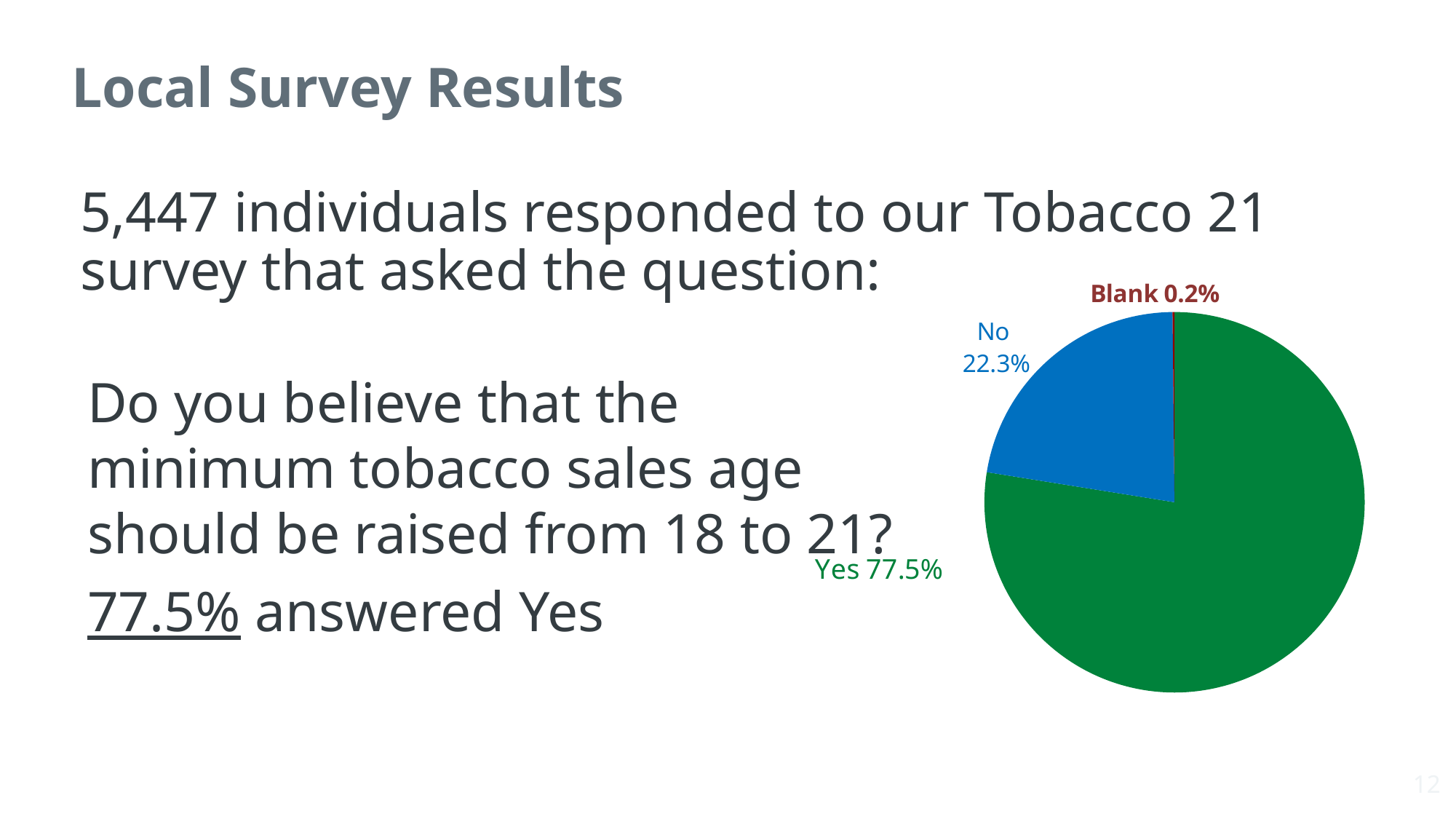
Which is larger, the No slice or the Blank slice? No What share of the pie does the Yes slice represent? 77.5% Which slice of the pie is the smallest? Blank What is the difference between the Yes and No percentages? 55.2% What colour is the Yes slice of the pie? green What is the combined percentage of the No and Blank slices? 22.5% How many slices does the pie chart have? 3 What share of the pie does the No slice represent? 22.3% What kind of chart is shown on the slide? pie chart Which slice of the pie is the largest? Yes What is the value shown for the Blank slice? 0.2% What colour is the No slice of the pie? blue